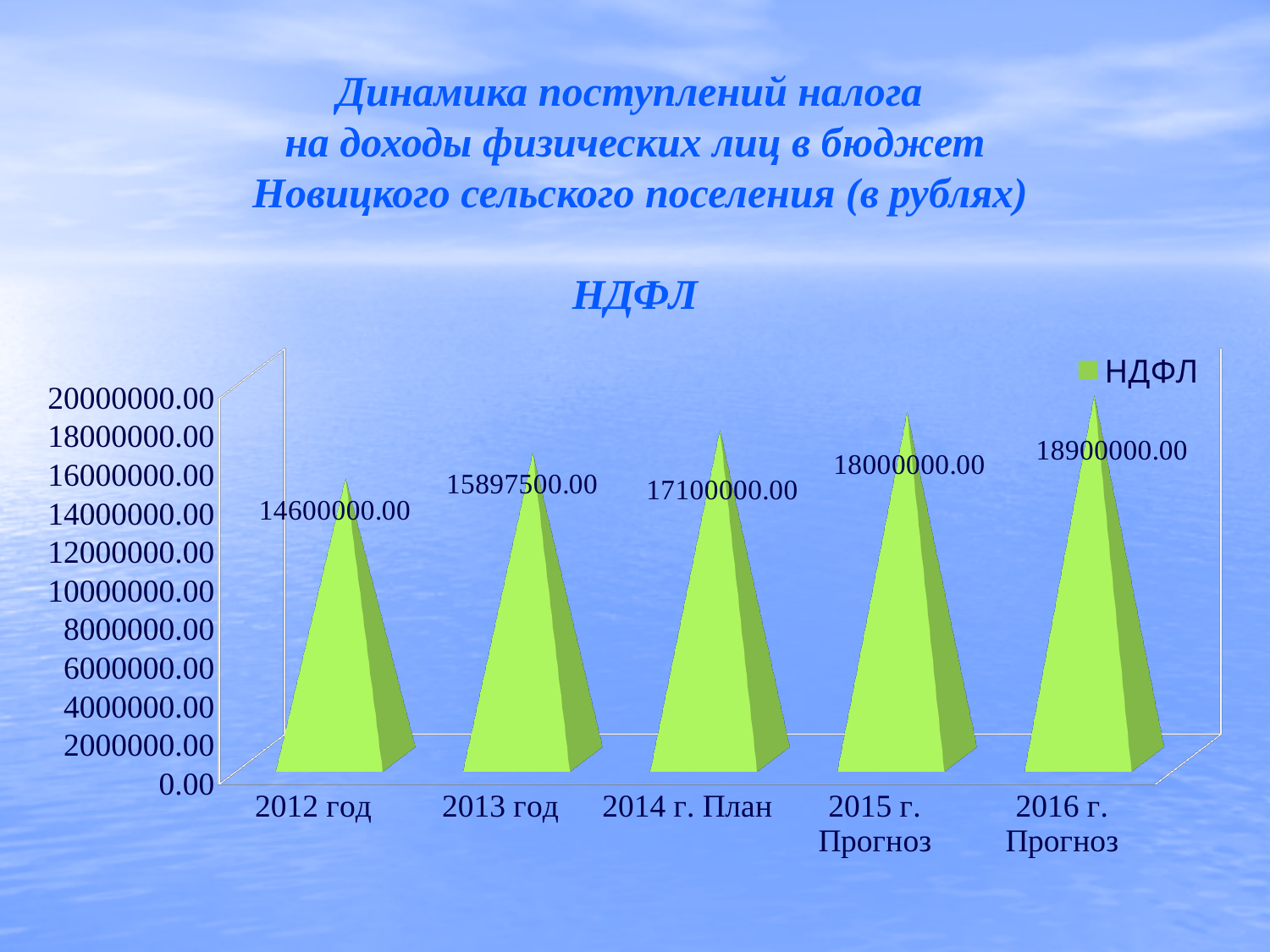
What is the value for 2012 год? 14600000.00 What is the value for 2014 г. План? 17100000.00 What is the value for 2016 г. Прогноз? 18900000.00 Which category has the lowest value? 2012 год Which category has the highest value? 2016 г. Прогноз How many categories are shown on the x axis? 5 What kind of chart is this? bar chart Do the values rise or fall from 2012 год to 2016 г. Прогноз? rise Which is larger, the value for 2013 год or the value for 2014 г. План? 2014 г. План What is the difference between the values for 2016 г. Прогноз and 2015 г. Прогноз? 900000.00 How many series does the legend list? 1 What is the value for 2013 год? 15897500.00